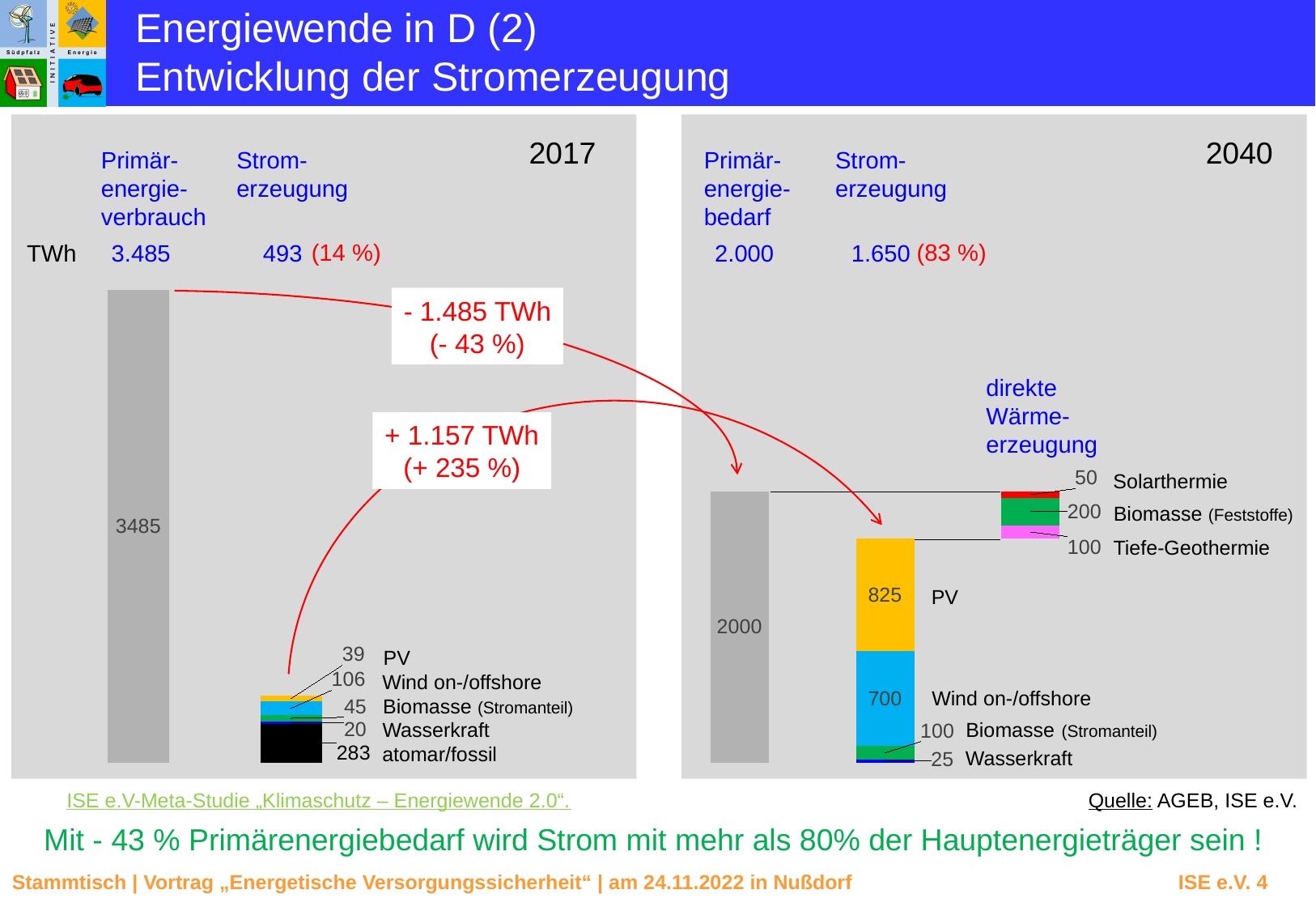
In the 2040 chart, which is larger: Wind on-/offshore or Biomasse (Stromanteil)? Wind on-/offshore In the 2017 chart, what is the value for Wind on-/offshore in the Stromerzeugung bar? 106 In the 2040 chart, what is the Primärenergiebedarf value in TWh? 2.000 In the 2040 chart, what is the value for PV in the Stromerzeugung bar? 825 In the 2040 chart, which segment of the Stromerzeugung bar is the largest? PV What kind of chart is used on this slide to show the Stromerzeugung values? Stacked bar chart In the 2017 chart, which segment of the Stromerzeugung bar is the smallest? Wasserkraft In the 2017 chart, how many segments does the Stromerzeugung stacked bar have? 5 By how much does the PV value in the 2040 chart exceed the PV value in the 2017 chart? 786 In the 2040 chart, what is the total of the Stromerzeugung stacked bar? 1.650 In the 2040 chart, what is the value for Tiefe-Geothermie in the direkte Wärmeerzeugung bar? 100 In the 2017 chart, which segment of the Stromerzeugung bar is the largest? atomar/fossil